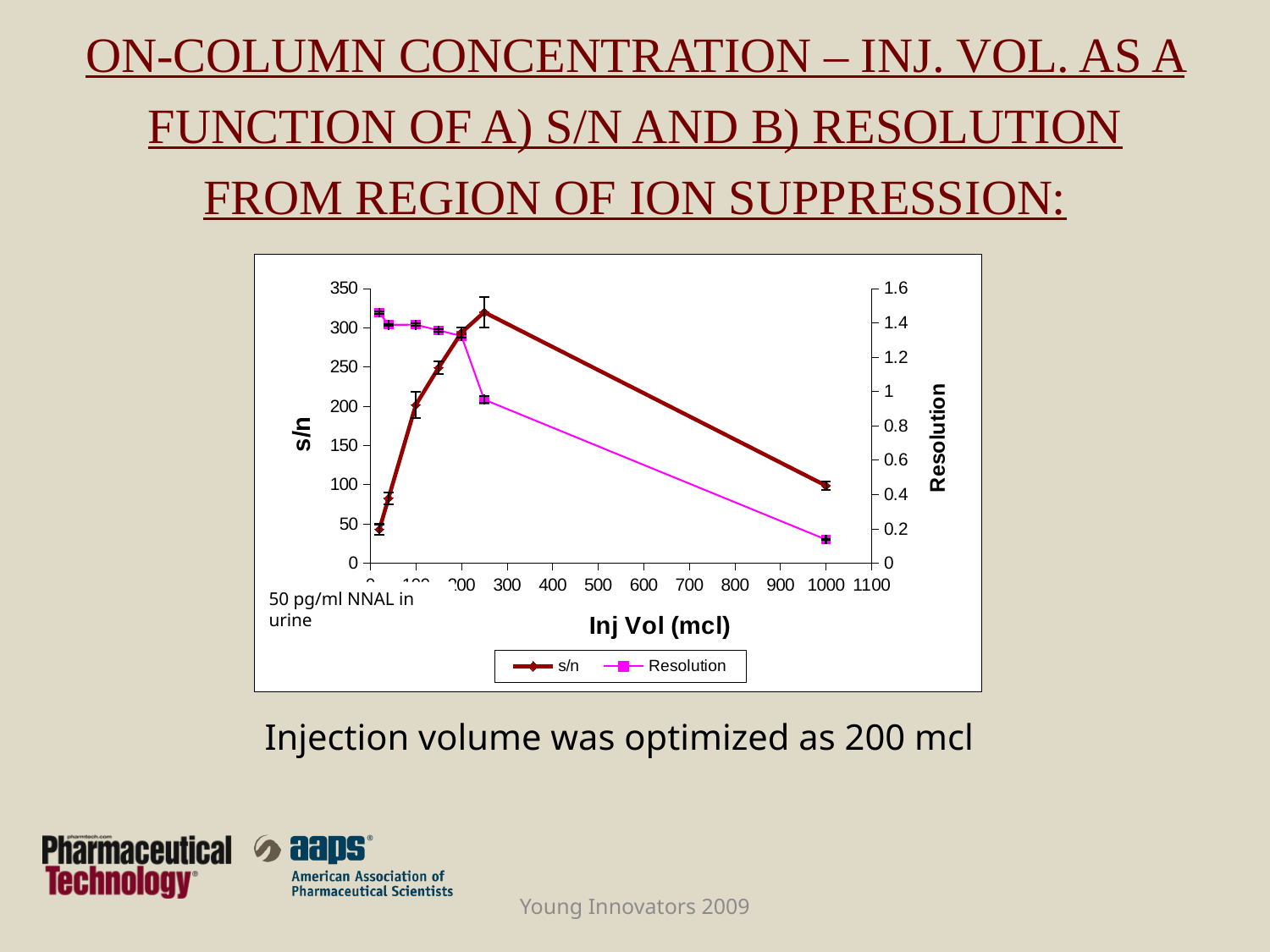
Which is larger, the Resolution value at 100 mcl or the Resolution value at 1000 mcl? 100 mcl Is the Resolution value at an injection volume of 1000 mcl greater or less than 0.2? less What is the title of the x axis? Inj Vol (mcl) Is the Resolution value at an injection volume of 250 mcl greater or less than 0.8? greater Which is larger, the s/n value at 250 mcl or the s/n value at 1000 mcl? 250 mcl Is the s/n value at an injection volume of 250 mcl greater or less than 300? greater What kind of chart is shown on the slide? line chart How many data points are plotted for the s/n series? 7 Does the Resolution series rise or fall as injection volume increases from 25 mcl to 1000 mcl? fall What are the two series named in the legend? s/n and Resolution How many series does the legend list? 2